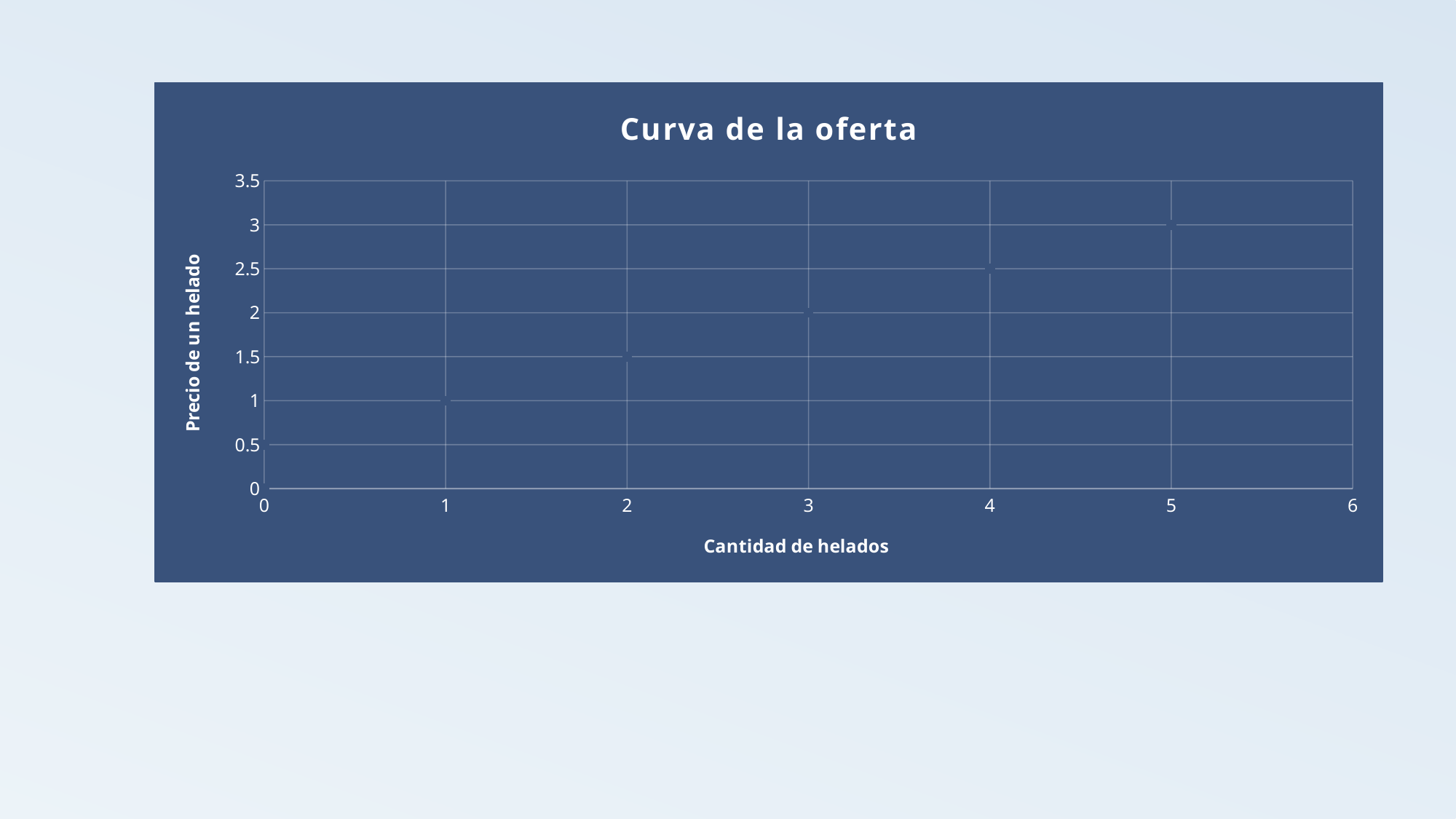
At which Cantidad de helados is the Precio de un helado highest? 5 What is the label of the vertical axis? Precio de un helado What is the Precio de un helado when Cantidad de helados is 3? 2 What is the Precio de un helado when Cantidad de helados is 5? 3 Is the Precio de un helado at Cantidad de helados 4 greater or less than 2? greater What is the Precio de un helado when Cantidad de helados is 1? 1 What is the difference in Precio de un helado between Cantidad de helados 4 and Cantidad de helados 2? 1 What is the title of the chart? Curva de la oferta Do the plotted values rise or fall as Cantidad de helados increases? rise What kind of chart is shown on the slide? scatter chart